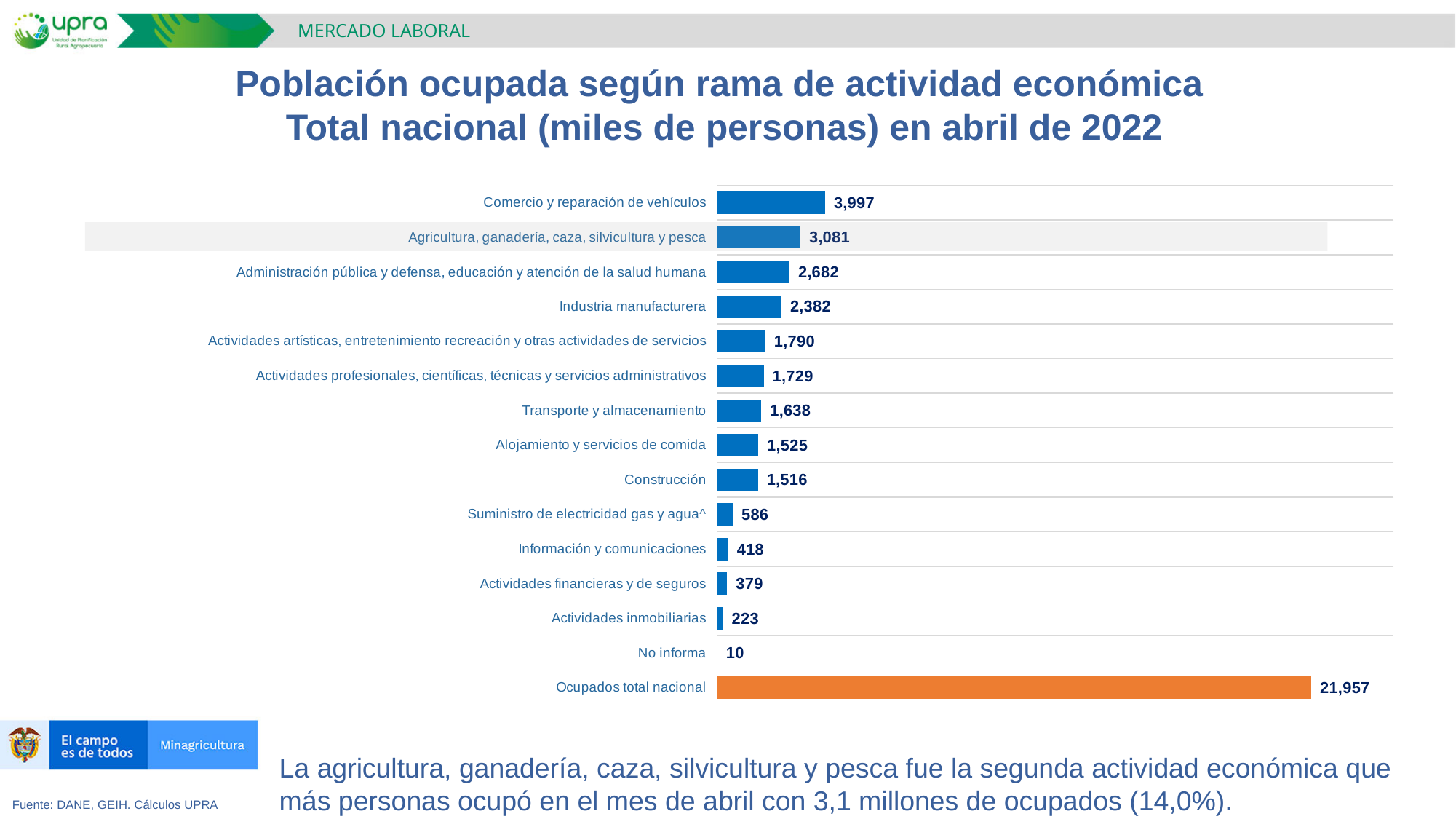
Which is larger, the value for Industria manufacturera or the value for Transporte y almacenamiento? Industria manufacturera What kind of chart is shown on the slide? Bar chart What is the value for Agricultura, ganadería, caza, silvicultura y pesca? 3,081 How many categories are shown in the chart? 15 Which bar is shown in orange rather than blue? Ocupados total nacional What is the difference between the values for Información y comunicaciones and Actividades financieras y de seguros? 39 What is the difference between the values for Comercio y reparación de vehículos and Agricultura, ganadería, caza, silvicultura y pesca? 916 What is the value for Construcción? 1,516 What is the value for Comercio y reparación de vehículos? 3,997 Which category has the lowest value? No informa What is the value for Ocupados total nacional? 21,957 Excluding the Ocupados total nacional bar, which economic activity has the highest value? Comercio y reparación de vehículos